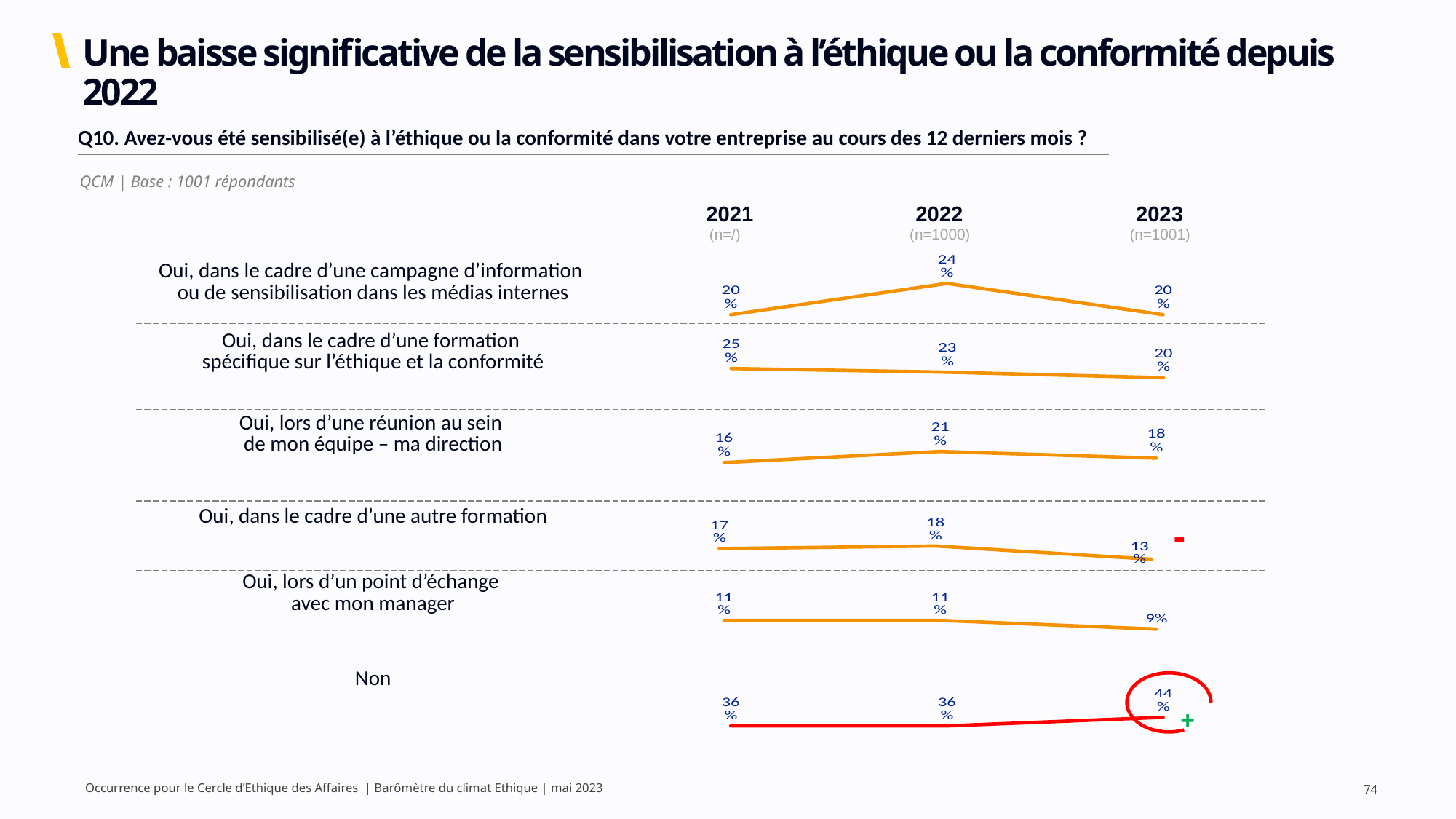
In the 'Oui, dans le cadre d'une autre formation' line chart, which year has the lowest value? 2023 In the 'Oui, dans le cadre d'une formation spécifique sur l'éthique et la conformité' line chart, do the values rise or fall from 2021 to 2023? Fall In the 'Non' line chart, what is the value for 2023? 44% How many years (data points) does each line chart on the slide show? 3 What colour is the line in the 'Non' chart? Red In the 'Oui, dans le cadre d'une formation spécifique sur l'éthique et la conformité' line chart, what is the difference between the 2021 value and the 2023 value? 5% What kind of chart is used for each response option on the slide? Line chart In the 'Oui, lors d'un point d'échange avec mon manager' line chart, what is the value for 2023? 9% In the 'Non' line chart, what is the difference between the 2023 value and the 2022 value? 8% In the 'Oui, dans le cadre d'une campagne d'information ou de sensibilisation dans les médias internes' line chart, which year has the highest value? 2022 In the 'Oui, lors d'une réunion au sein de mon équipe – ma direction' line chart, which is larger, the 2022 value or the 2021 value? 2022 In the 'Oui, dans le cadre d'une formation spécifique sur l'éthique et la conformité' line chart, what is the value for 2021? 25%